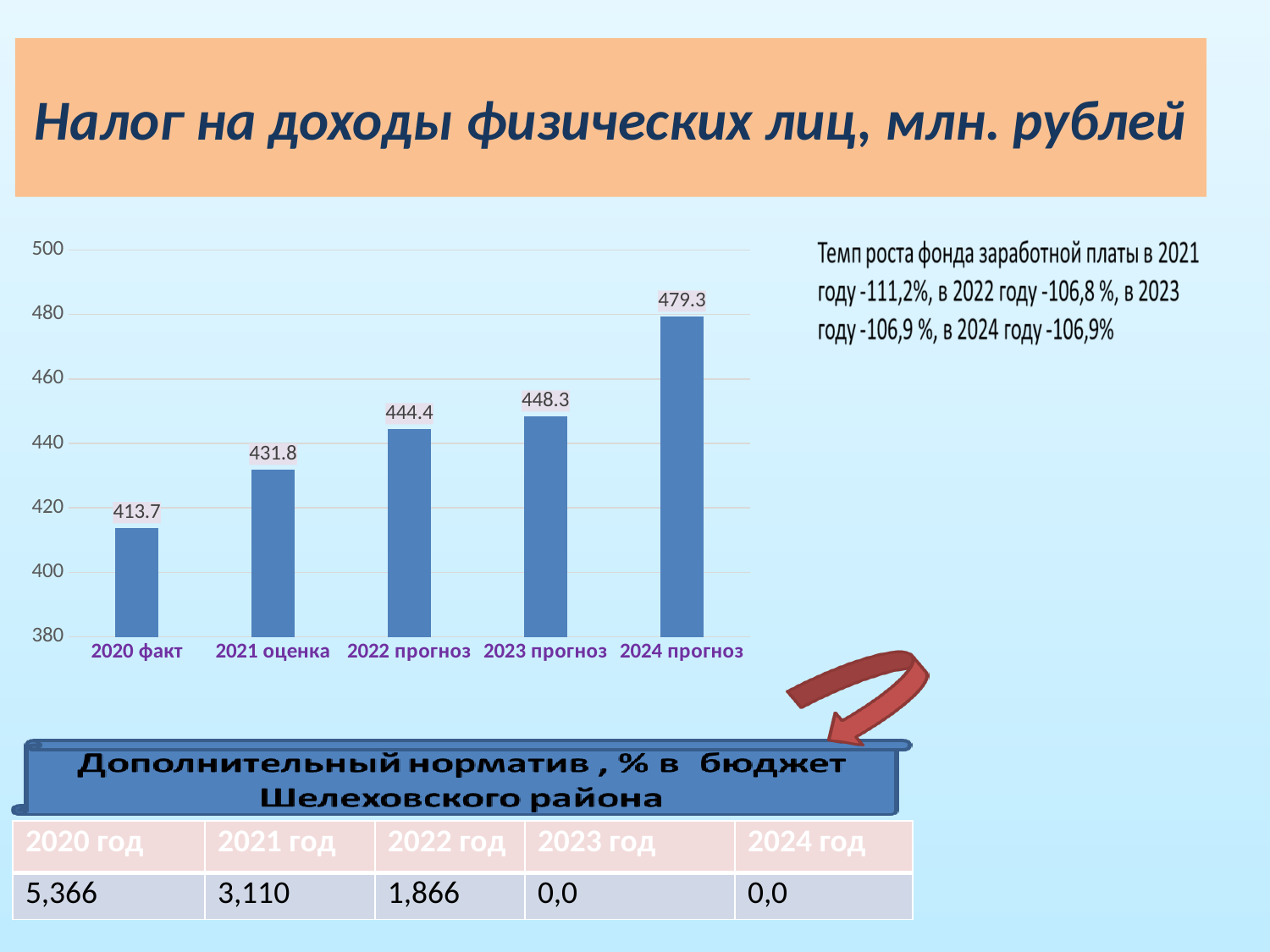
Which category has the lowest value? 2020 факт What is the value for 2024 прогноз? 479.3 What is the value for 2022 прогноз? 444.4 How many categories are shown on the x axis of the chart? 5 What is the difference between the values for 2021 оценка and 2020 факт? 18.1 Which category has the highest value? 2024 прогноз Is the value for 2023 прогноз greater or less than 440? greater What kind of chart is shown on the slide? bar chart What is the value for 2020 факт? 413.7 Which is larger, the value for 2022 прогноз or the value for 2021 оценка? 2022 прогноз What is the difference between the values for 2024 прогноз and 2023 прогноз? 31 Do the values rise or fall from 2020 факт to 2024 прогноз? rise